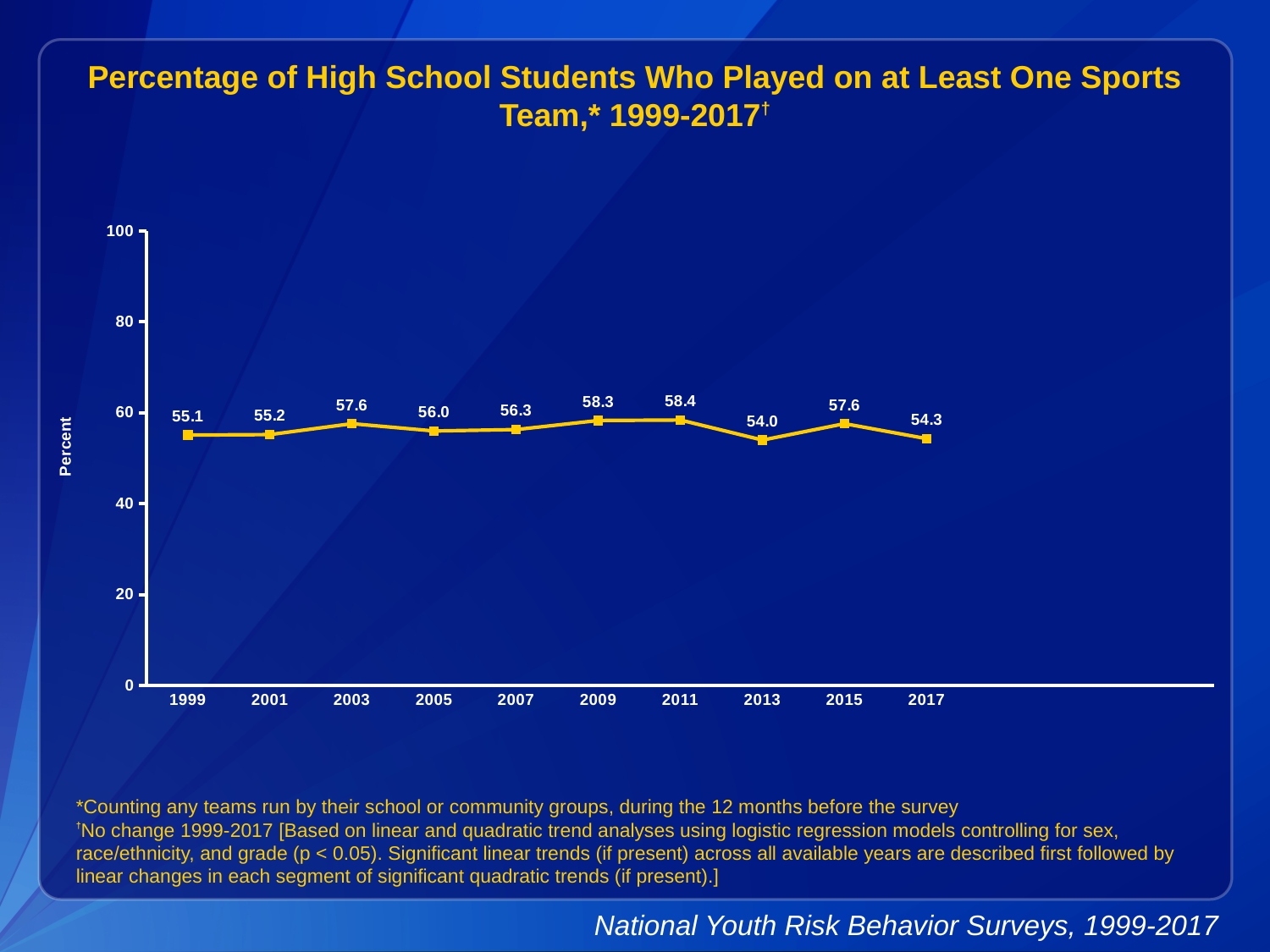
What is the difference between the values for 2011 and 2013? 4.4 Which year has the lowest value on the chart? 2013 What is the label on the y axis? Percent What is the maximum value shown on the y axis? 100 Which year has the highest value on the chart? 2011 Which year has the larger value, 2003 or 2005? 2003 What is the value plotted for 2011? 58.4 How many years are plotted on the x axis? 10 Is the value for 2009 greater or less than 40? greater What percentage of high school students played on at least one sports team in 1999? 55.1 What is the value plotted for 2017? 54.3 What kind of chart is shown on the slide? Line chart